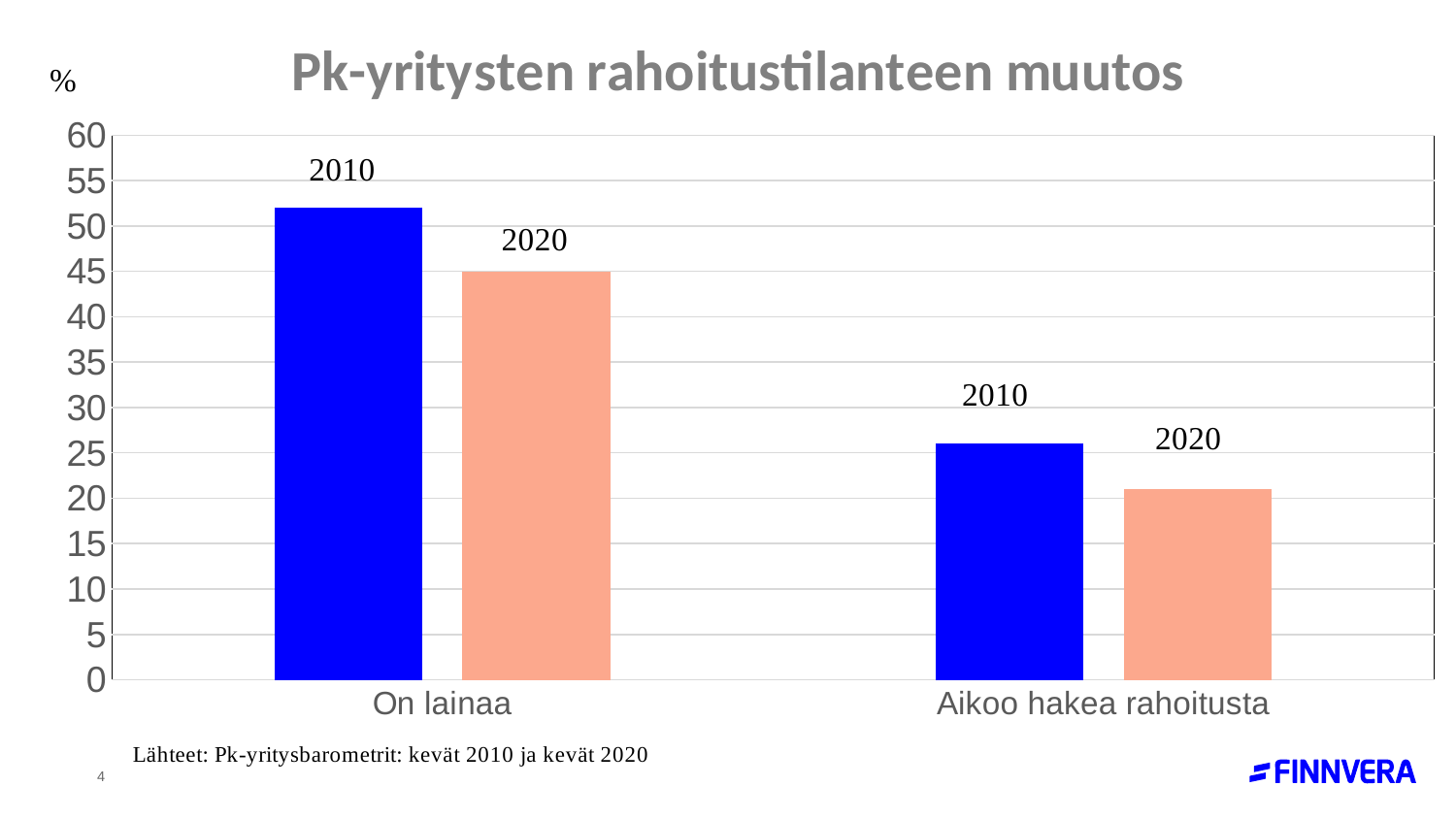
Which bar is the lowest in the chart? Aikoo hakea rahoitusta, 2020 What kind of chart is shown on the slide? bar chart Is the 2010 value for 'On lainaa' greater or less than 50? greater Which years are compared for each category in the chart? 2010 and 2020 For 'Aikoo hakea rahoitusta', which year has the larger value, 2010 or 2020? 2010 From 2010 to 2020, do the values rise or fall in both categories? fall Is the 2020 value for 'On lainaa' greater or less than 40? greater Is the 2010 value for 'Aikoo hakea rahoitusta' greater or less than 30? less Which bar is the highest in the chart? On lainaa, 2010 How many categories are shown on the x axis of the chart? 2 What is the title of the chart? Pk-yritysten rahoitustilanteen muutos For 'On lainaa', which year has the larger value, 2010 or 2020? 2010